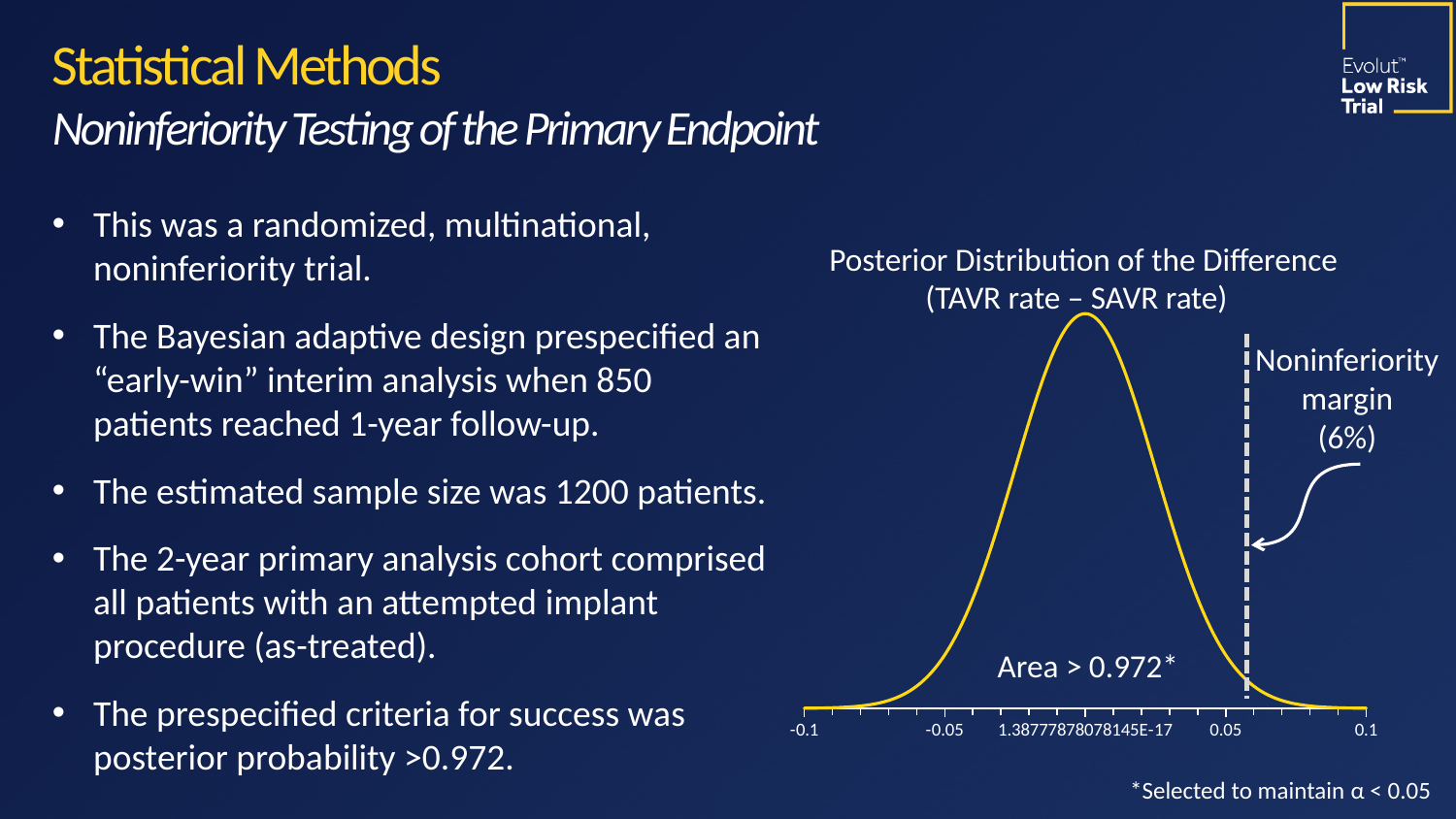
What is the highest value labeled on the x axis of the chart? 0.1 How many tick labels are printed on the x axis of the chart? 5 What is the title of the chart on the slide? Posterior Distribution of the Difference (TAVR rate – SAVR rate) What value is given for the noninferiority margin marked by the dashed line on the chart? 6% What area value is annotated under the curve on the chart? Area > 0.972* Is the peak of the curve located to the left or to the right of the dashed noninferiority margin line? left What does the footnote below the chart say the asterisk was selected to maintain? α < 0.05 Moving from left to right along the x axis, does the curve rise and then fall, or fall and then rise? rise and then fall What is the lowest value labeled on the x axis of the chart? -0.1 What kind of chart is shown on the right side of the slide? line chart Is the x-axis position of the curve's peak greater or less than 0.05? less